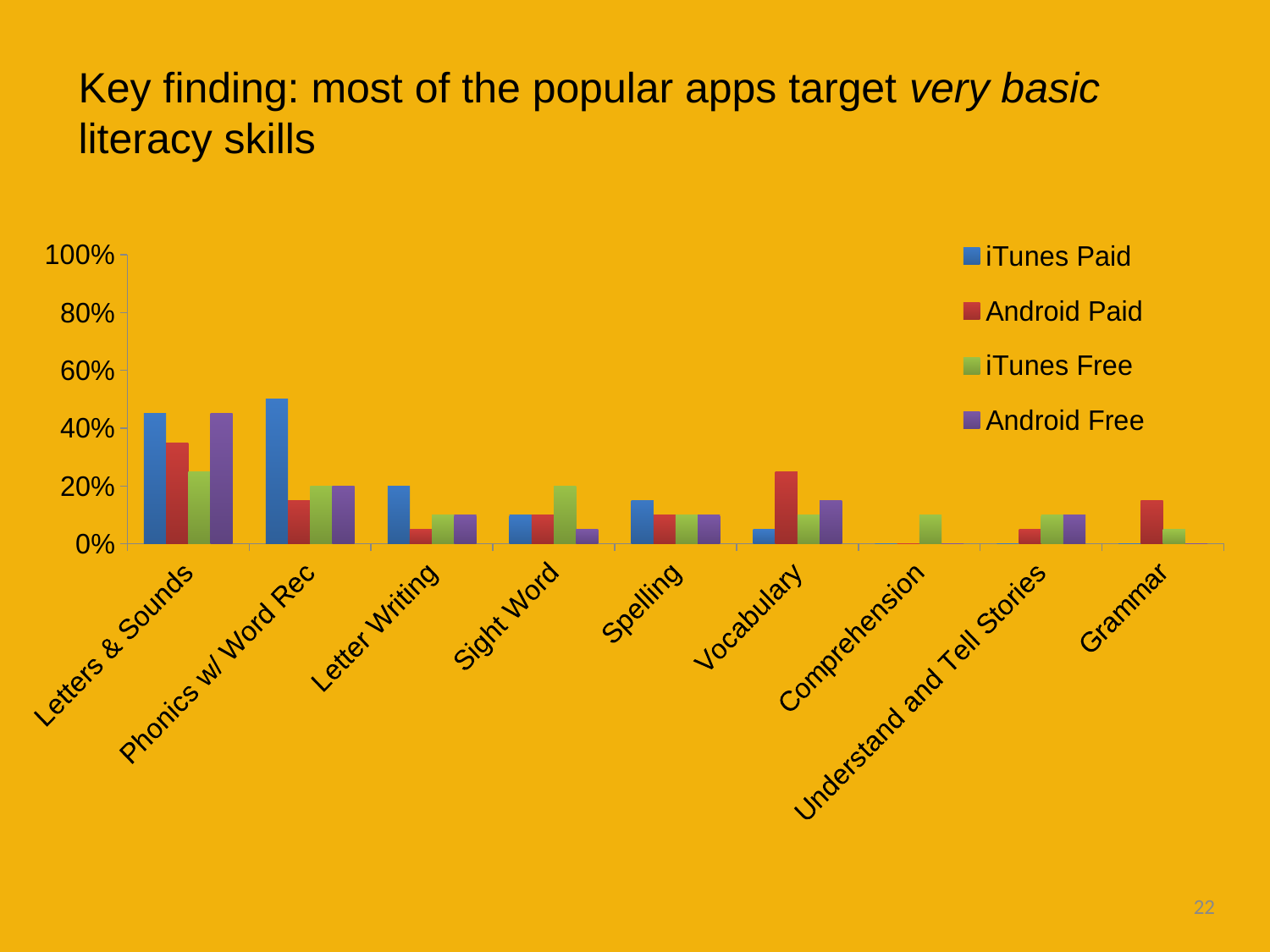
What kind of chart is shown on the slide? Bar chart Which category has the highest iTunes Paid bar? Phonics w/ Word Rec Is the iTunes Paid value for Letters & Sounds greater or less than 40%? greater What is the iTunes Paid value for Letter Writing? 20% Is the Android Paid value for Vocabulary greater or less than 20%? greater How many literacy skill categories are shown on the x axis? 9 For Vocabulary, which is larger: Android Paid or iTunes Paid? Android Paid For Letters & Sounds, which is larger: iTunes Paid or Android Paid? iTunes Paid Is the Android Paid value for Phonics w/ Word Rec greater or less than 20%? less What colour represents Android Free in the legend? Purple Which series has the highest bar for Grammar? Android Paid How many series does the legend list? 4